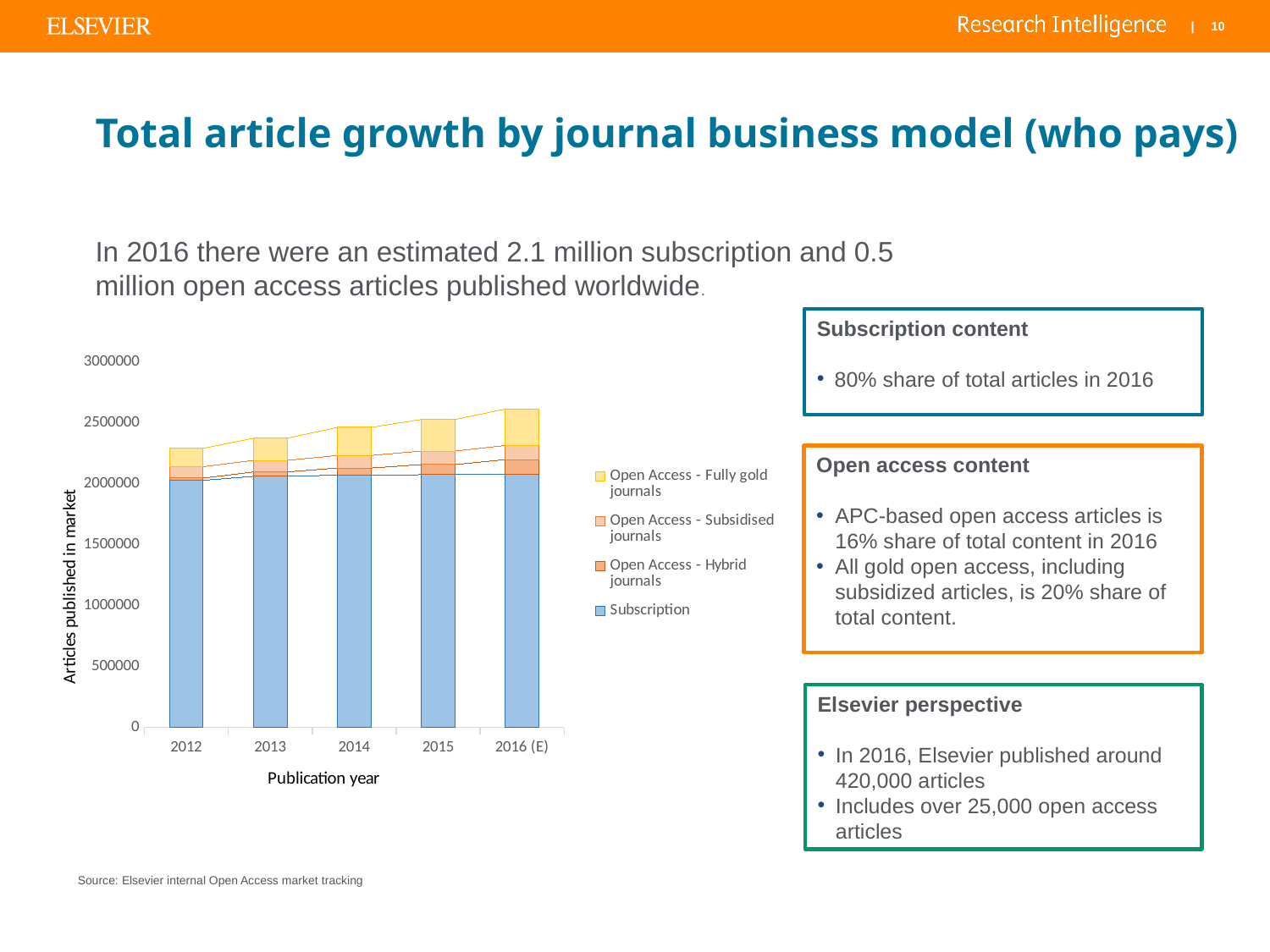
Which publication year has the shortest stacked bar in the chart? 2012 Which is larger: the total stacked bar for 2016 (E) or for 2012? 2016 (E) What kind of chart is shown on the slide? Stacked bar chart Do the total stacked bar heights rise or fall from 2012 to 2016 (E)? Rise Is the Subscription value for 2014 greater or less than 1500000? greater How many publication years are shown on the x axis of the chart? 5 Is the total stacked bar for 2013 greater or less than 2500000? less What is the title of the chart's y axis? Articles published in market What is the title of the chart's x axis? Publication year Which publication year has the tallest stacked bar in the chart? 2016 (E) Is the total stacked bar for 2012 greater or less than 2500000? less How many series does the chart's legend list? 4